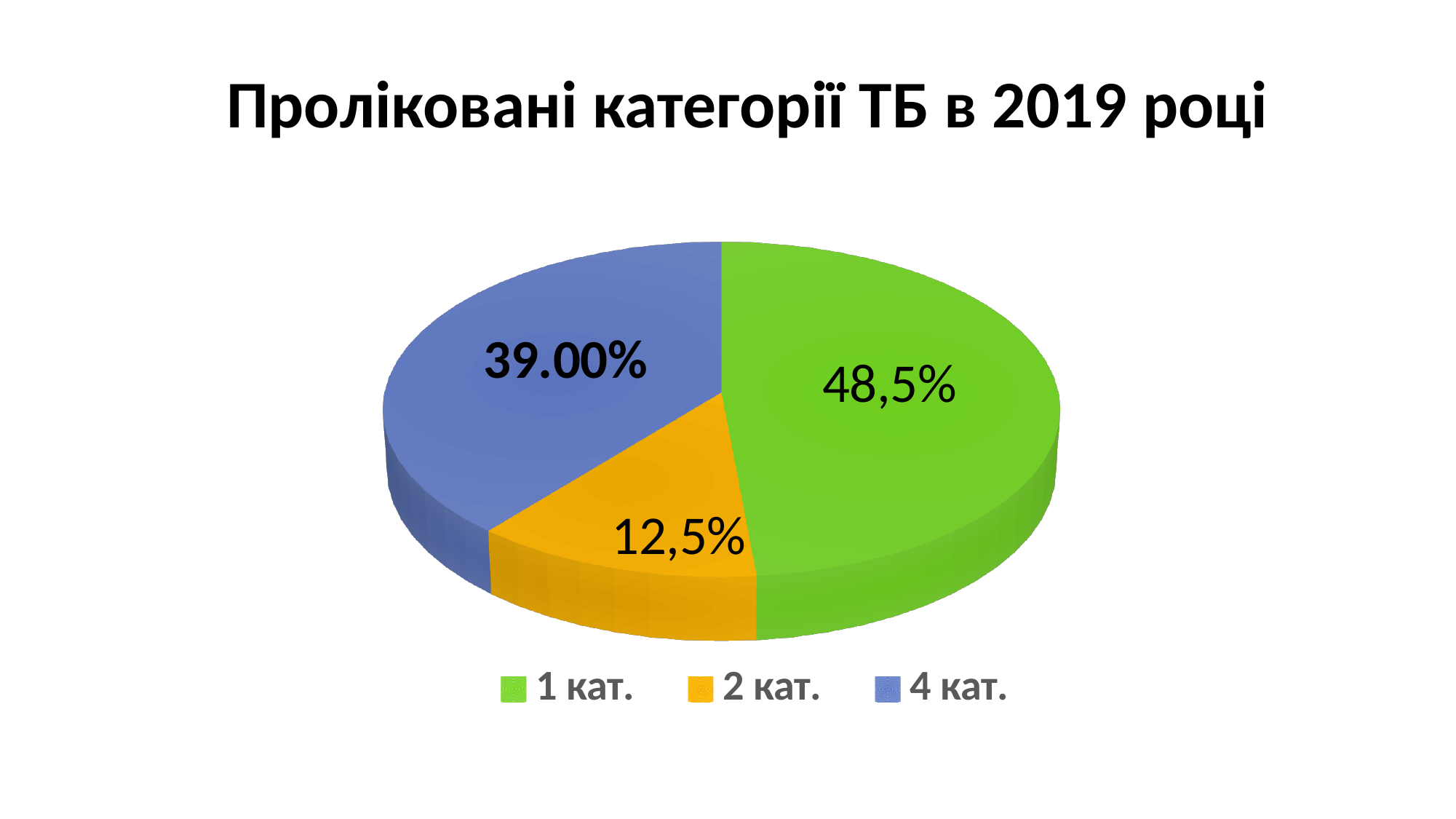
What colour is the slice for 4 кат.? blue What is the difference in percentage points between the 1 кат. slice and the 2 кат. slice? 36 percentage points Which category has the largest slice of the pie? 1 кат. Which is larger, the slice for 4 кат. or the slice for 2 кат.? 4 кат. Which category has the smallest slice of the pie? 2 кат. How many entries does the legend list? 3 What share of the pie does 4 кат. have? 39.00% How many slices does the pie chart have? 3 What kind of chart is shown on the slide? pie chart What is the title of the chart? Проліковані категорії ТБ в 2019 році What share of the pie does 1 кат. have? 48,5% What share of the pie does 2 кат. have? 12,5%